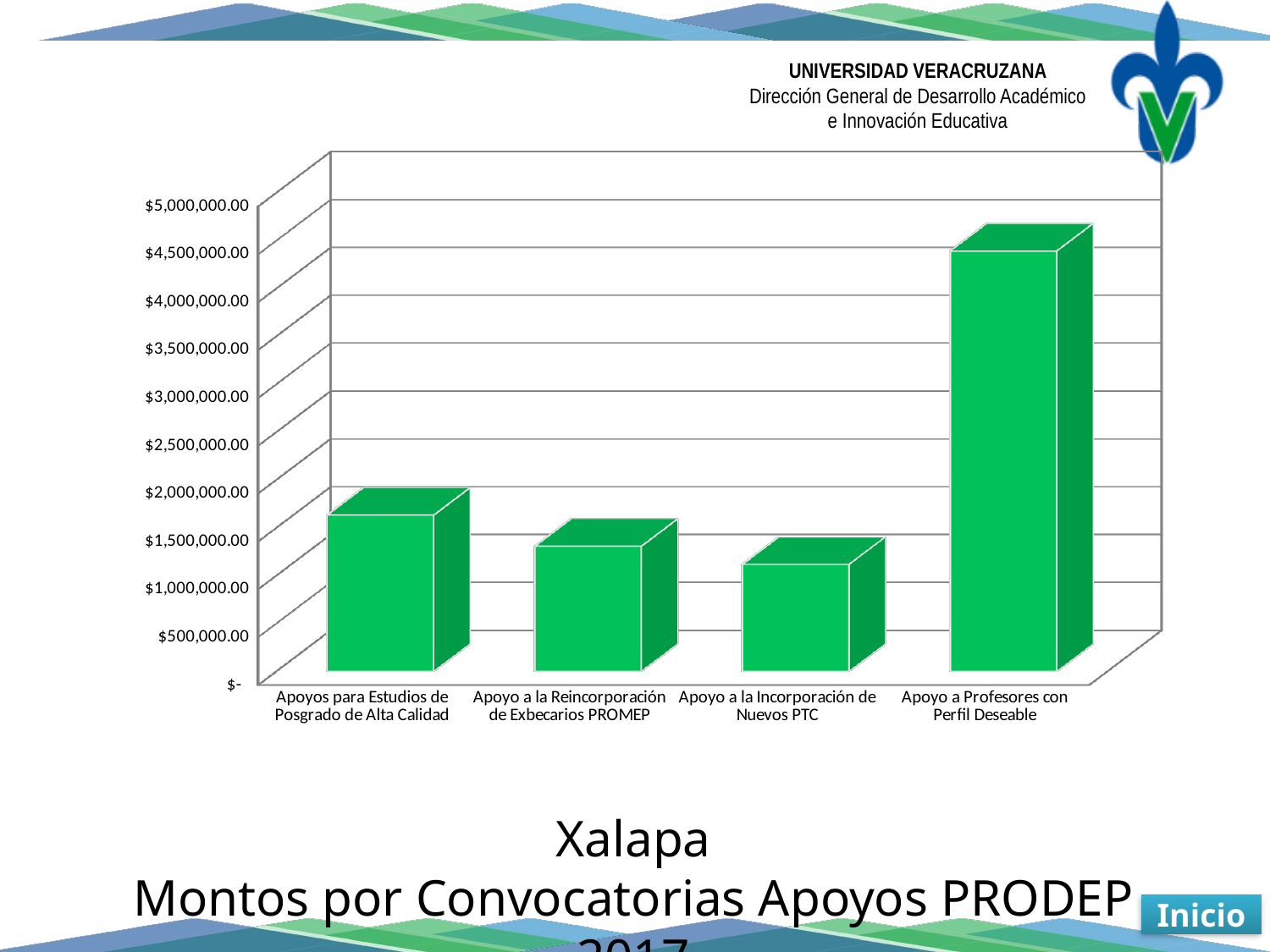
What colour are the bars in the chart? Green Which is larger: the value for Apoyos para Estudios de Posgrado de Alta Calidad or the value for Apoyo a la Reincorporación de Exbecarios PROMEP? Apoyos para Estudios de Posgrado de Alta Calidad Which category has the lowest value in the chart? Apoyo a la Incorporación de Nuevos PTC Which category has the highest value in the chart? Apoyo a Profesores con Perfil Deseable Which is larger: the value for Apoyo a Profesores con Perfil Deseable or the value for Apoyo a la Incorporación de Nuevos PTC? Apoyo a Profesores con Perfil Deseable What kind of chart is shown on the slide? Bar chart Is the value for Apoyo a Profesores con Perfil Deseable greater or less than $4,000,000.00? greater Is the value for Apoyo a la Reincorporación de Exbecarios PROMEP greater or less than $2,000,000.00? less Is the value for Apoyo a Profesores con Perfil Deseable greater or less than $5,000,000.00? less How many categories are plotted in the chart? 4